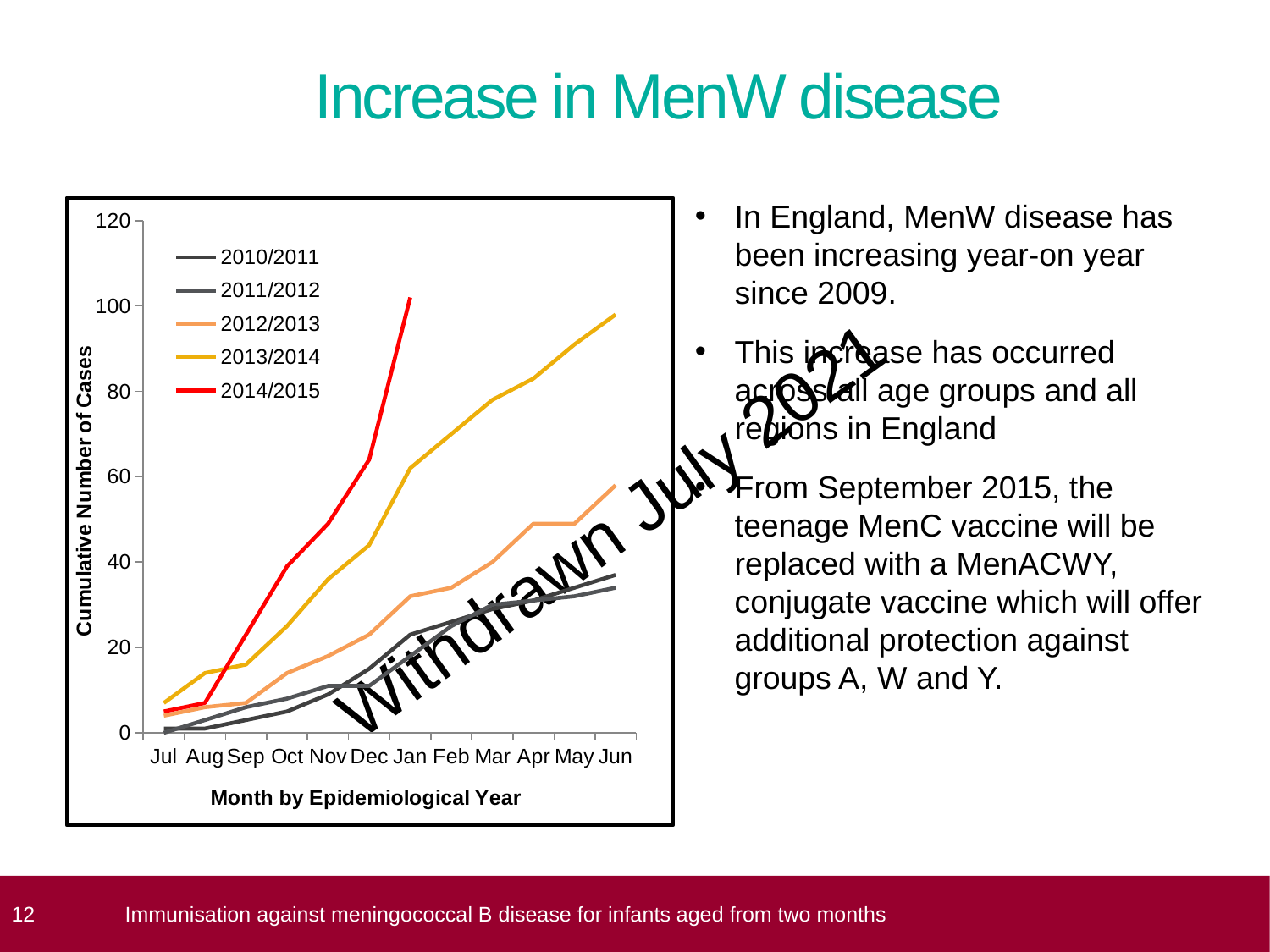
How many months are shown along the x axis? 12 How many series does the legend list? 5 Is the cumulative number of cases for 2011/2012 in Jun greater or less than 20? greater Is the cumulative number of cases for 2013/2014 in Jun greater or less than 80? greater Does the 2013/2014 line rise or fall from Jul to Jun? rise Is the cumulative number of cases for 2014/2015 in Jan greater or less than 80? greater In Dec, which series has the higher cumulative number of cases, 2014/2015 or 2013/2014? 2014/2015 Which series reaches the highest cumulative number of cases on the chart? 2014/2015 What kind of chart is shown on the slide? line chart What is the title of the y axis? Cumulative Number of Cases What is the title of the x axis? Month by Epidemiological Year